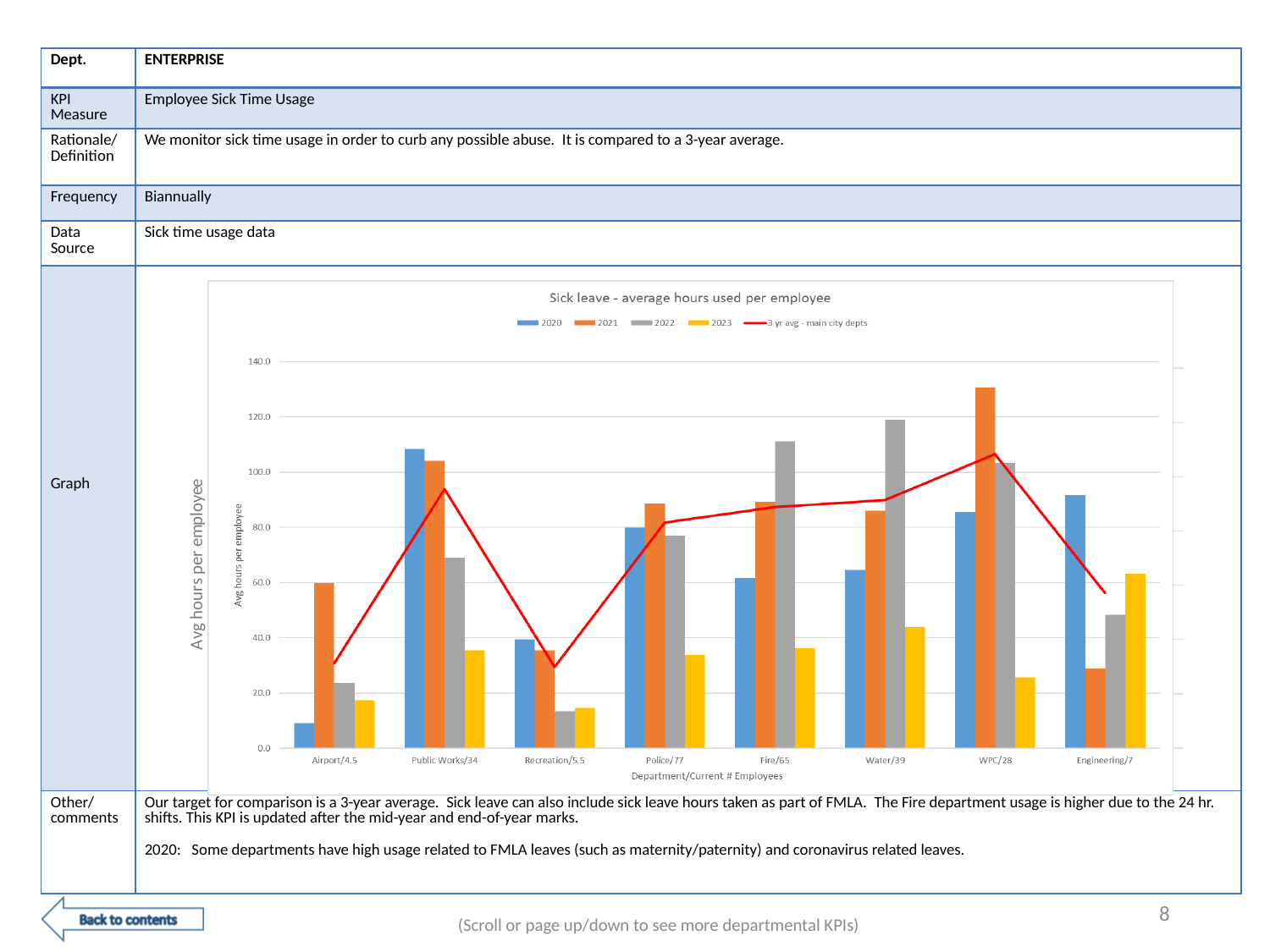
Which is larger, the 2020 value for Public Works/34 or the 2020 value for Police/77? Public Works/34 What is the title of the chart? Sick leave - average hours used per employee Is the 2022 value for Fire/65 greater or less than 100? greater Does the 3 yr avg - main city depts line rise or fall from WPC/28 to Engineering/7? fall Is the 2021 value for WPC/28 greater or less than 120? greater Which department has the highest 2022 value? Water/39 How many department categories are shown on the x axis? 8 What type of chart is shown on the slide? Bar chart with a line Which department has the lowest 2020 value? Airport/4.5 Which department has the highest 2021 value? WPC/28 Is the 2020 value for Airport/4.5 greater or less than 20? less How many series does the chart legend list? 5